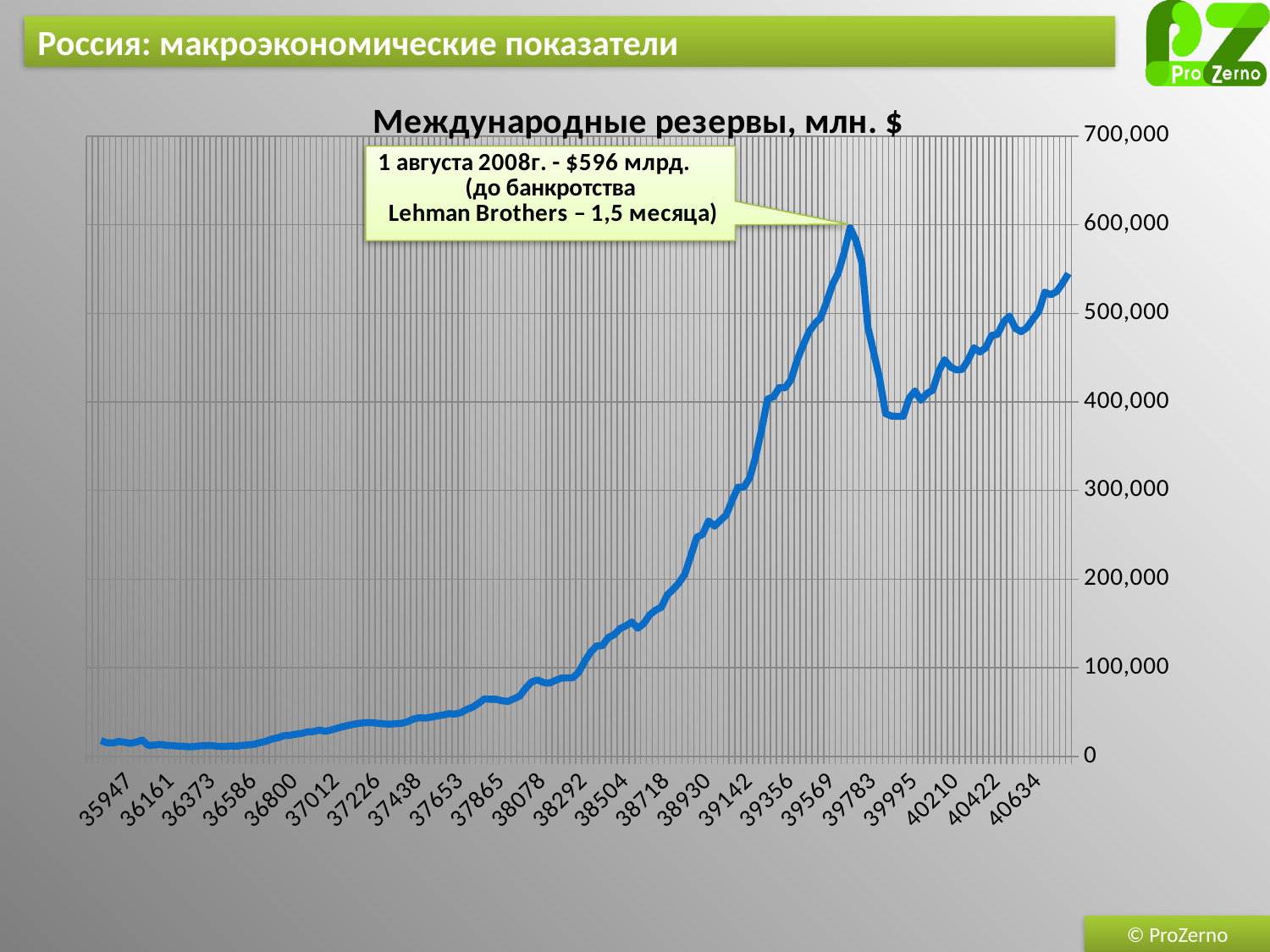
According to the callout on the chart, what was the value of international reserves on 1 August 2008? $596 млрд. Does the line rise or fall immediately after its peak near x label 39569? fall Is the value at x label 38078 greater or less than 100,000? less According to the callout, how long before the Lehman Brothers bankruptcy was the 1 August 2008 peak? 1,5 месяца Is the value at x label 35947 greater or less than 100,000? less What is the title of the chart? Международные резервы, млн. $ Does the line generally rise or fall between x labels 35947 and 39569? rise How many data series are plotted on the chart? 1 What kind of chart is shown on the slide? line chart What is the highest value shown on the vertical axis? 700,000 Is the value at x label 38718 greater or less than 200,000? less